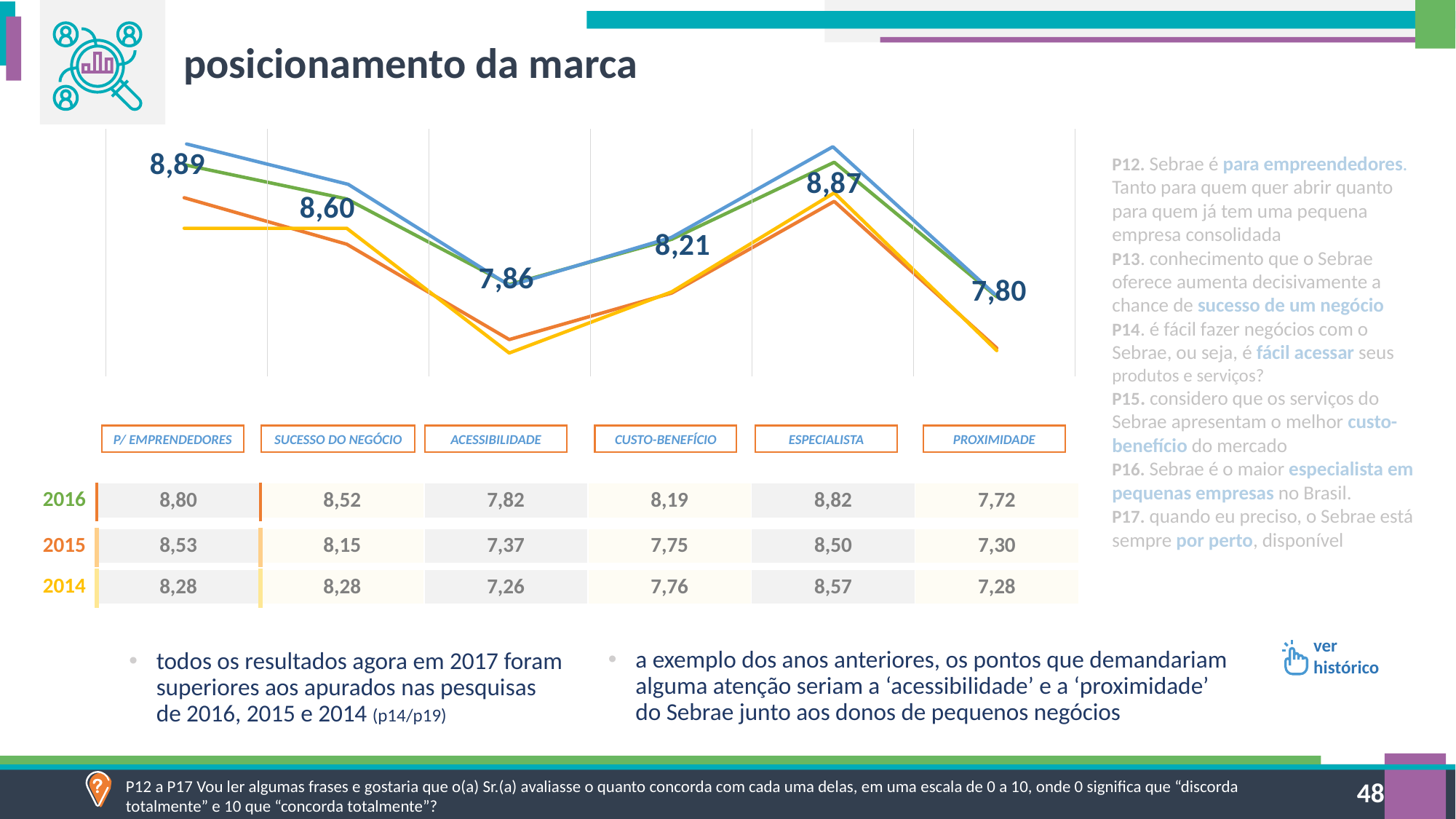
What is the 2017 value (data label on the blue line) for ACESSIBILIDADE? 7,86 Which category has the highest 2017 value on the blue line? P/ EMPRENDEDORES What is the 2017 value (data label on the blue line) for ESPECIALISTA? 8,87 According to the table, what is the 2016 value for CUSTO-BENEFÍCIO? 8,19 Which category has the lowest 2017 value on the blue line? PROXIMIDADE According to the table, what is the 2014 value for PROXIMIDADE? 7,28 How many lines (years) are plotted on the chart? 4 What is the 2017 value (data label on the blue line) for P/ EMPRENDEDORES? 8,89 How many categories are shown along the x axis of the chart? 6 What is the difference between the 2017 values for P/ EMPRENDEDORES (8,89) and ACESSIBILIDADE (7,86)? 1,03 In the table, which is larger: the 2015 value for ESPECIALISTA or the 2015 value for PROXIMIDADE? ESPECIALISTA (8,50) What type of chart is shown on the slide? Line chart